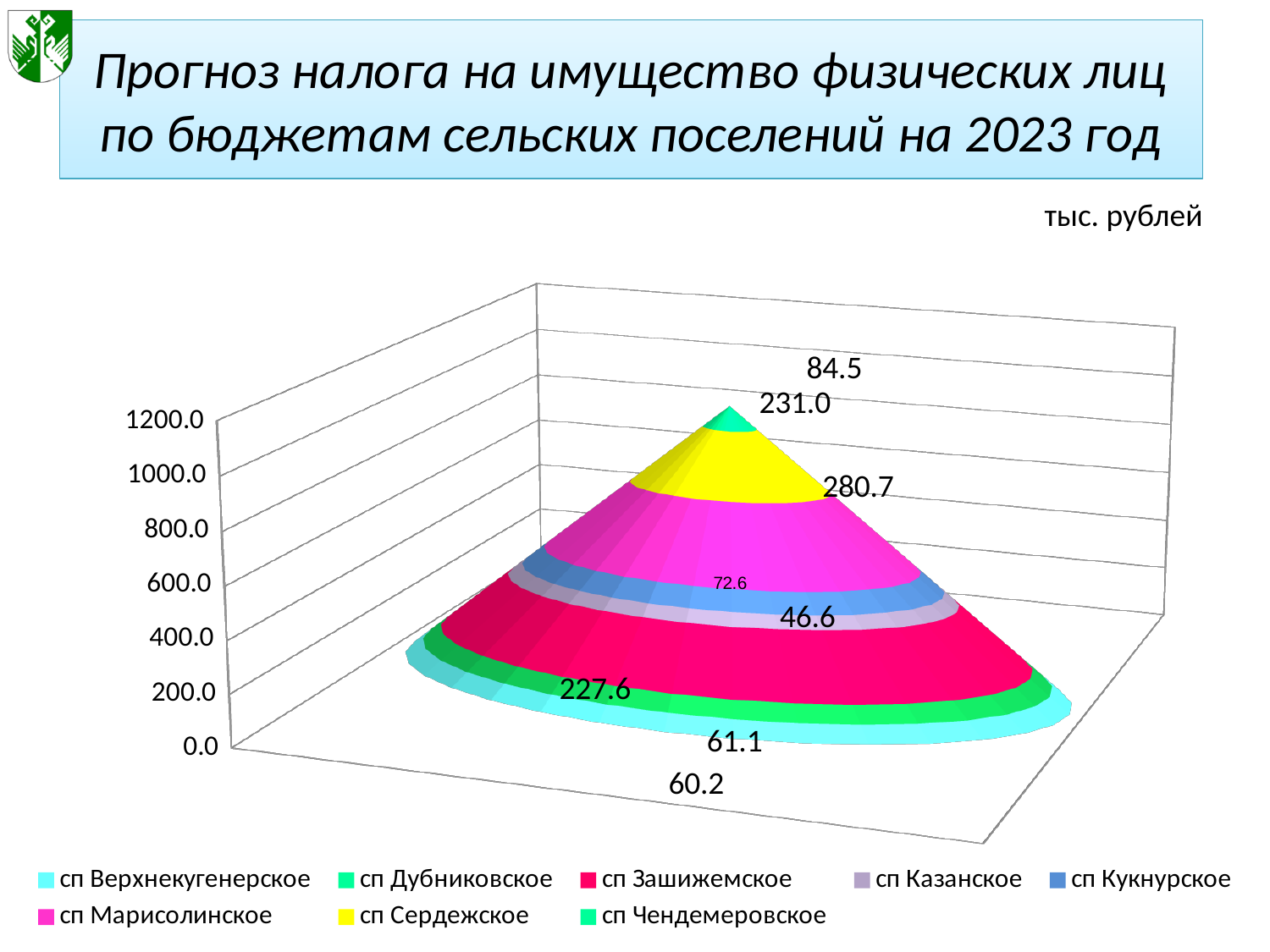
What unit of measurement is indicated above the chart? тыс. рублей What is the value for сп Чендемеровское? 84.5 What is the value for сп Зашижемское? 227.6 Which is larger, the value for сп Дубниковское or сп Верхнекугенерское? сп Дубниковское What is the value for сп Казанское? 46.6 What is the value for сп Марисолинское? 280.7 What is the difference between the values for сп Марисолинское and сп Сердежское? 49.7 Which settlement has the highest forecast value? сп Марисолинское How many series does the legend list? 8 What is the total of all the stacked segments? 1064.3 Which settlement has the lowest forecast value? сп Казанское What kind of chart is shown on the slide? 3D stacked cone chart